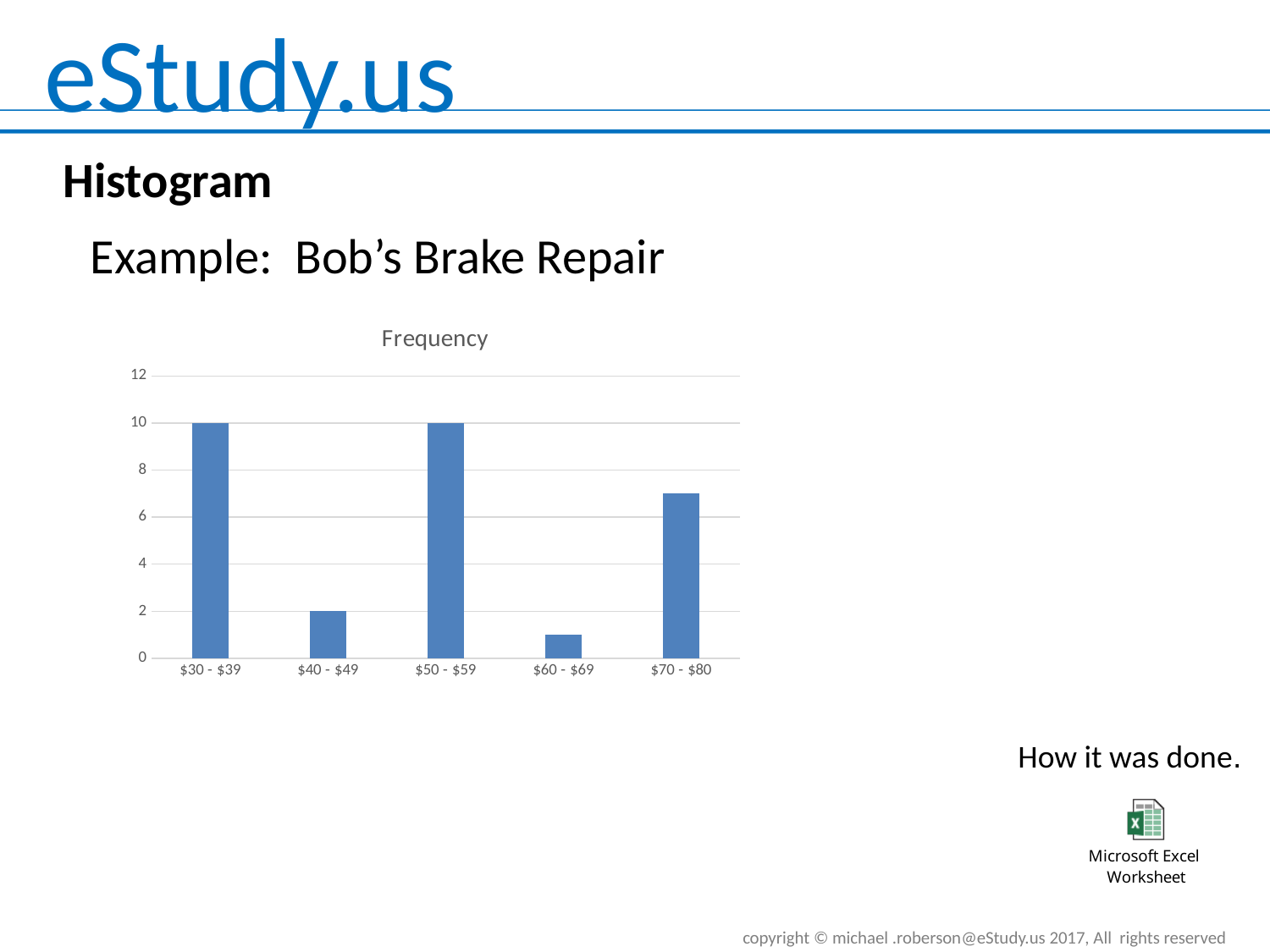
Which is larger, the value for $70 - $80 or the value for $60 - $69? $70 - $80 How many categories are shown on the x axis? 5 Is the value for $70 - $80 greater or less than 8? less What is the difference between the values for $50 - $59 and $40 - $49? 8 Is the value for $60 - $69 greater or less than 2? less What is the value for $30 - $39? 10 What kind of chart is shown? bar chart Which category has the lowest value? $60 - $69 What is the value for $40 - $49? 2 What is the value for $50 - $59? 10 Is the value for $70 - $80 greater or less than 6? greater Which is larger, the value for $30 - $39 or the value for $40 - $49? $30 - $39